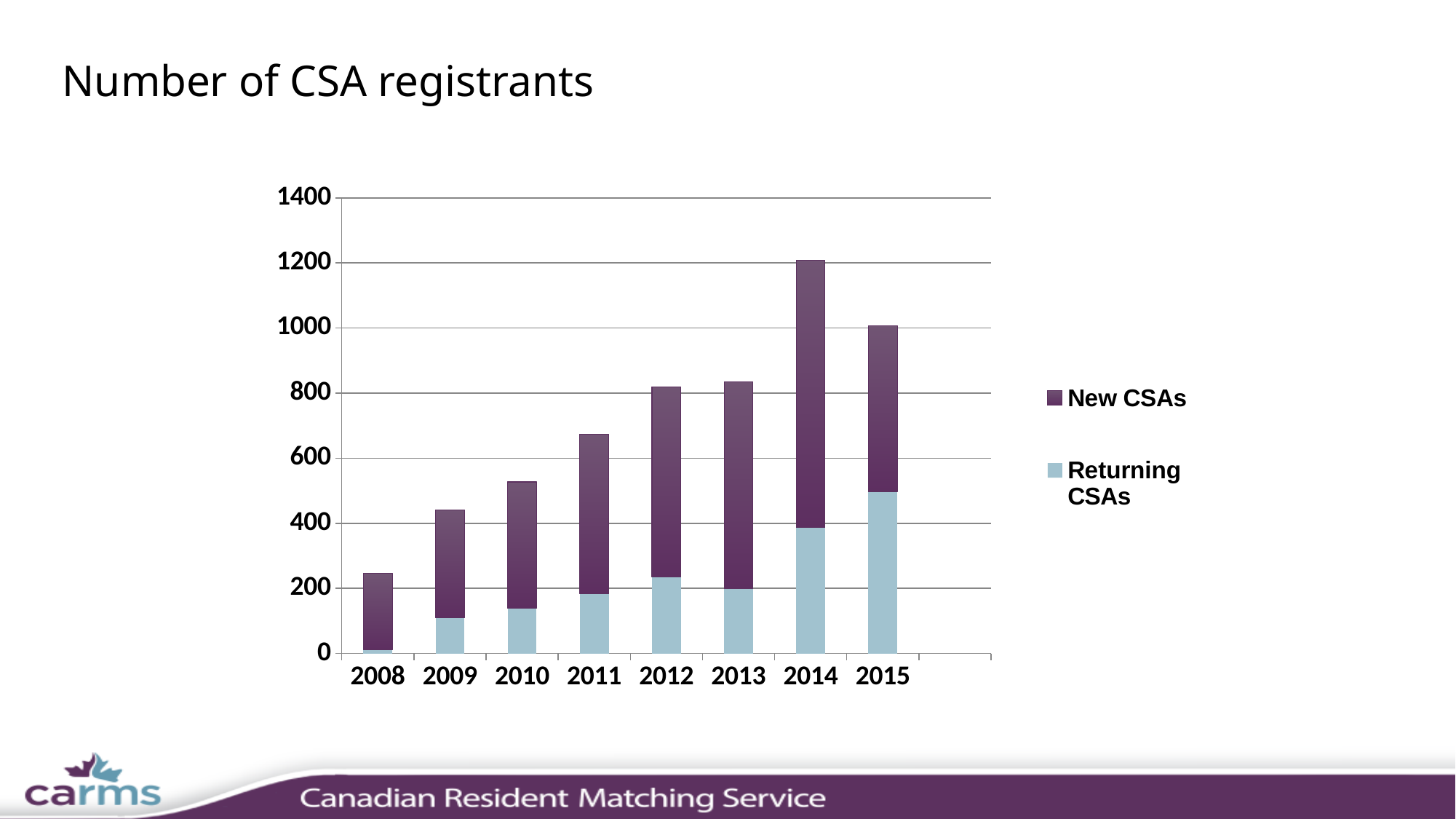
How many years are shown on the x axis of the chart? 8 Is the number of Returning CSAs in 2009 greater or less than 200? less Is the total number of CSA registrants in 2011 greater or less than 600? greater How many series does the chart's legend list? 2 Which year has more Returning CSAs, 2012 or 2013? 2012 Which year has the shortest total bar? 2008 What kind of chart is shown on the slide? stacked bar chart Which year has the tallest total bar? 2014 Is the number of Returning CSAs in 2015 greater or less than 400? greater Which year has more total CSA registrants, 2014 or 2015? 2014 What is the title of the chart on the slide? Number of CSA registrants